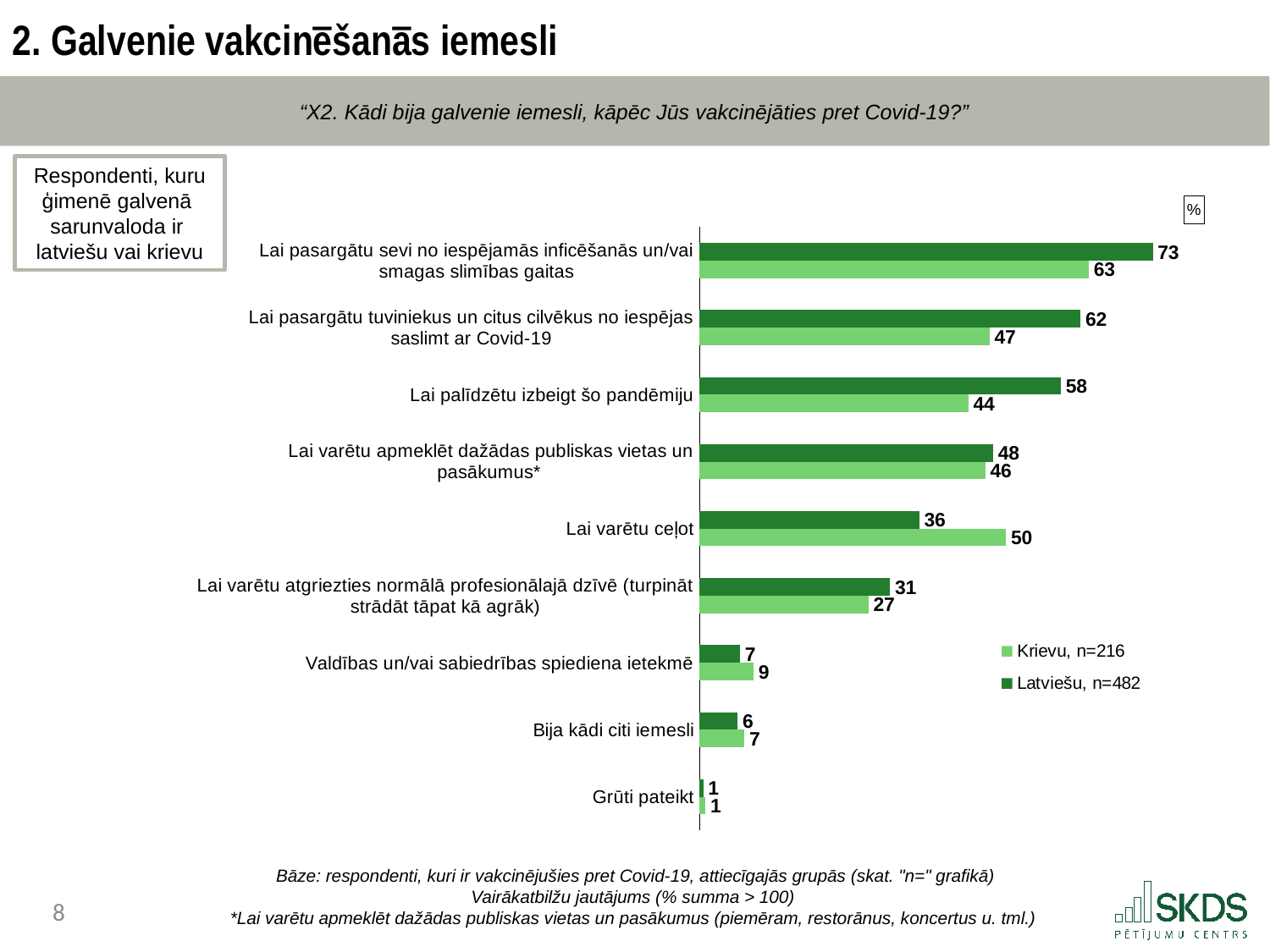
For "Lai varētu ceļot", which series has the larger value, "Krievu, n=216" or "Latviešu, n=482"? Krievu, n=216 Which series is shown in dark green in the legend? Latviešu, n=482 What kind of chart is shown on the slide? Bar chart What is the value for "Krievu, n=216" for "Lai palīdzētu izbeigt šo pandēmiju"? 44 How many series does the legend list? 2 What is the value for "Krievu, n=216" for "Lai varētu ceļot"? 50 Which category has the highest value for "Latviešu, n=482"? Lai pasargātu sevi no iespējamās inficēšanās un/vai smagas slimības gaitas What is the difference between the "Latviešu, n=482" and "Krievu, n=216" values for "Lai pasargātu tuviniekus un citus cilvēkus no iespējas saslimt ar Covid-19"? 15 Which category has the lowest value for "Krievu, n=216"? Grūti pateikt For "Lai palīdzētu izbeigt šo pandēmiju", which series has the larger value, "Krievu, n=216" or "Latviešu, n=482"? Latviešu, n=482 How many categories are shown in the chart? 9 What is the value for "Latviešu, n=482" for "Lai pasargātu sevi no iespējamās inficēšanās un/vai smagas slimības gaitas"? 73